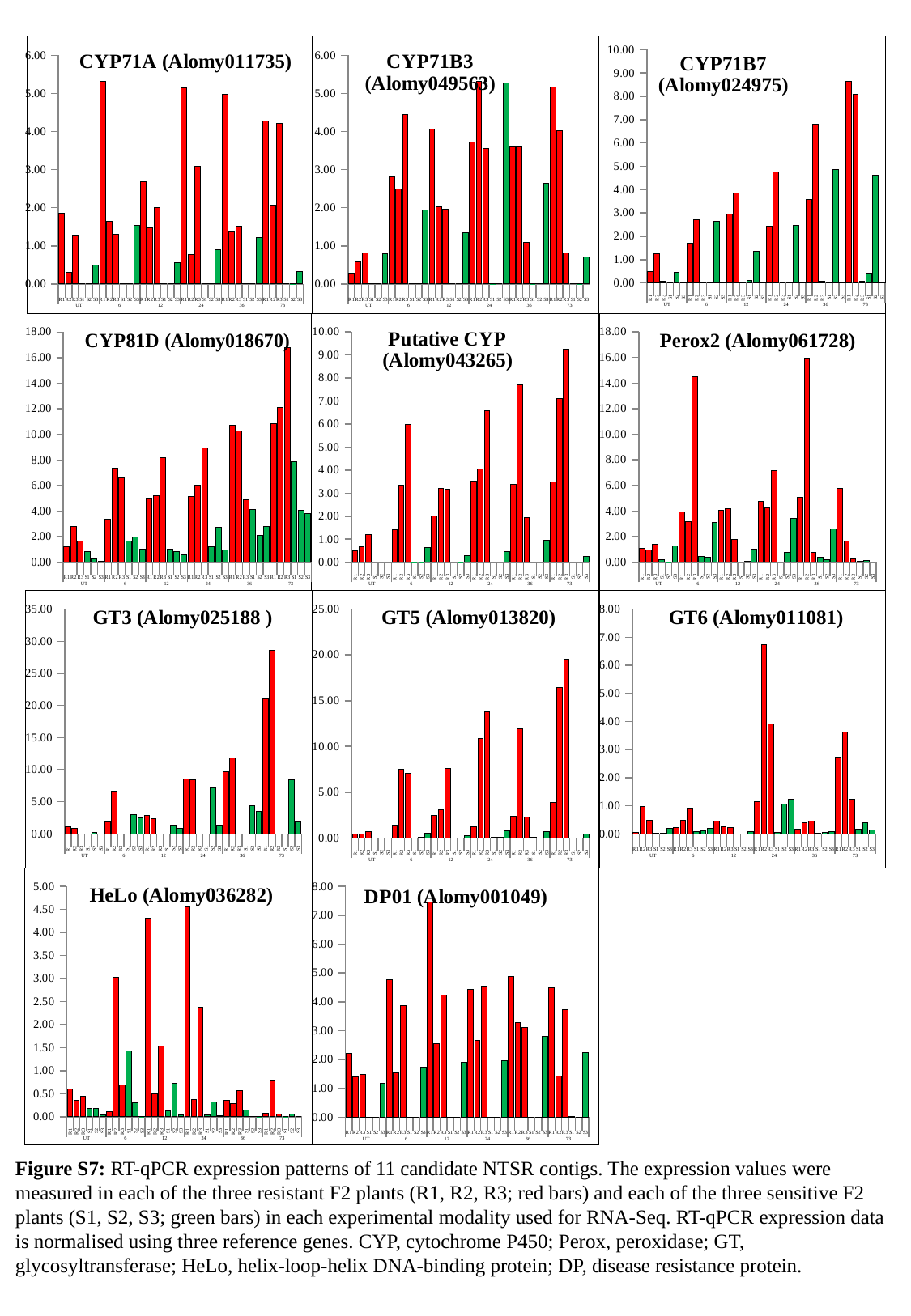
In the GT5 (Alomy013820) chart, is the tallest bar greater or less than 15.00? greater In the Perox2 (Alomy061728) chart, is the tallest bar greater or less than 14.00? greater What is the maximum value shown on the y axis of the CYP81D (Alomy018670) chart? 18.00 How many charts are shown on the slide? 11 What kind of chart is used for CYP71A (Alomy011735)? bar chart In the GT3 (Alomy025188) chart, is the tallest bar greater or less than 25.00? greater What is the maximum value shown on the y axis of the GT3 (Alomy025188) chart? 35.00 In the GT3 (Alomy025188) chart, which is taller: the tallest red bar or the tallest green bar? the tallest red bar